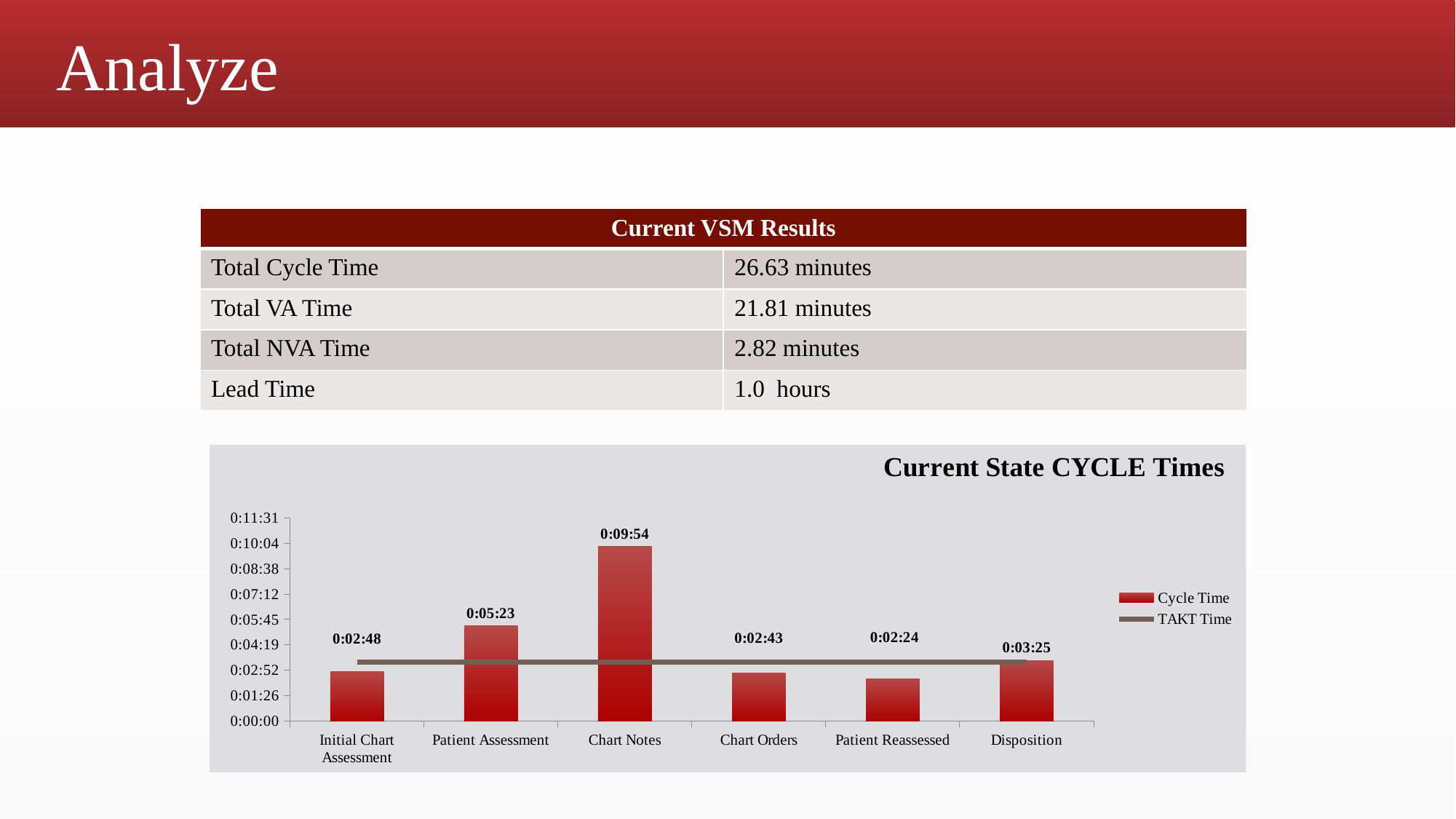
What is the title of the chart? Current State CYCLE Times How many process steps are shown on the x axis? 6 What is the Cycle Time for Disposition? 0:03:25 What is the difference in Cycle Time between Chart Notes and Patient Assessment? 0:04:31 What is the Cycle Time for Chart Notes? 0:09:54 Which has a larger Cycle Time, Initial Chart Assessment or Disposition? Disposition What is the Cycle Time for Patient Reassessed? 0:02:24 Which step has the lowest Cycle Time? Patient Reassessed Which step has the highest Cycle Time? Chart Notes How many series does the legend list? 2 Is the Cycle Time for Chart Notes greater or less than 0:08:38? greater What kind of chart is shown? bar chart